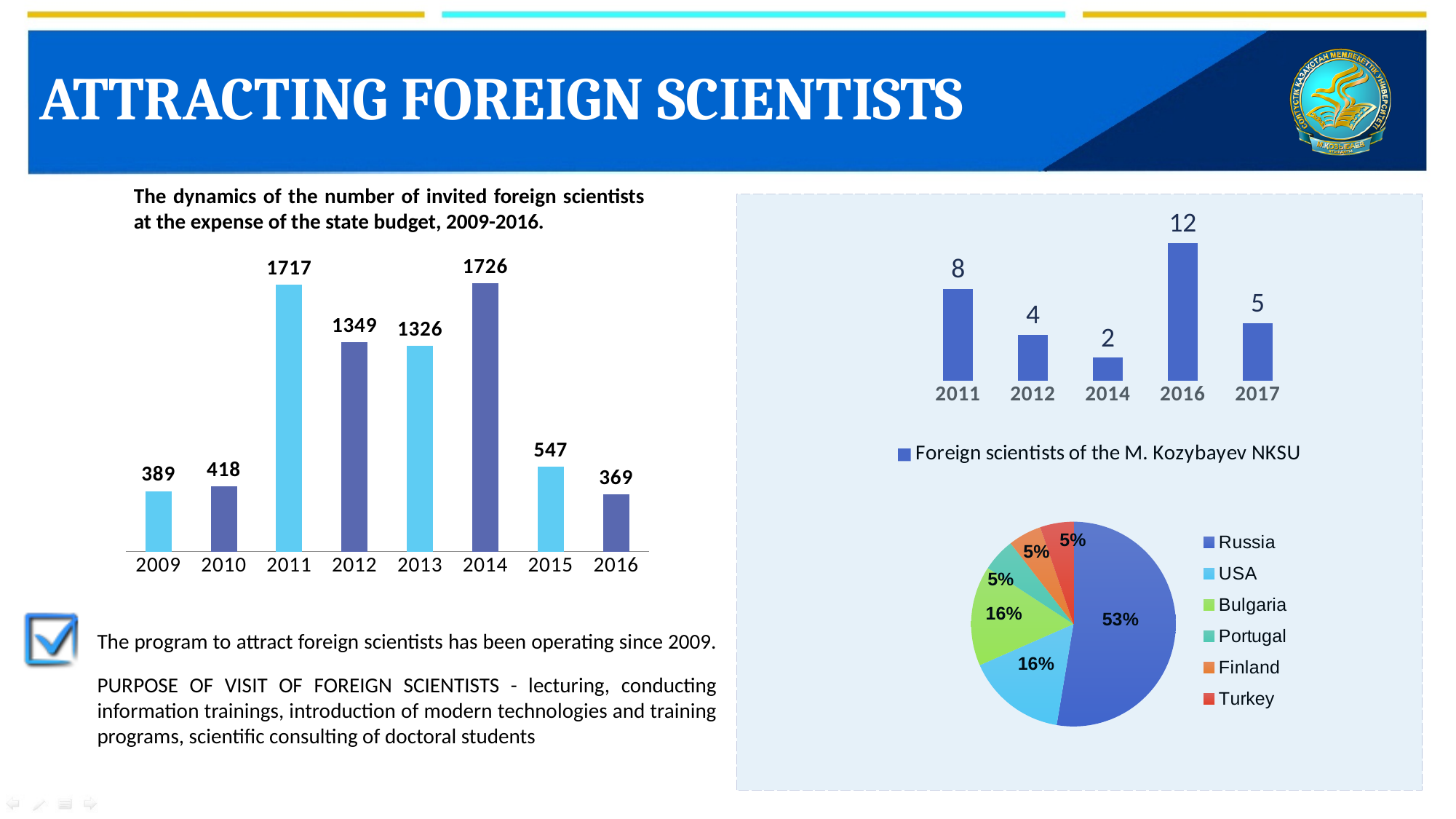
In the left bar chart on the dynamics of invited foreign scientists, which year has the highest value? 2014 In the pie chart at the bottom right, what share does Russia have? 53% In the left bar chart on the dynamics of invited foreign scientists, which is larger, the value for 2012 or the value for 2013? 2012 What kind of chart is the top-right chart 'Foreign scientists of the M. Kozybayev NKSU'? bar chart In the left bar chart on the dynamics of invited foreign scientists, how many years are shown on the x axis? 8 In the left bar chart on the dynamics of invited foreign scientists, what is the difference between the values for 2014 and 2015? 1179 In the top-right chart 'Foreign scientists of the M. Kozybayev NKSU', which year has the lowest value? 2014 In the left bar chart on the dynamics of invited foreign scientists, which year has the lowest value? 2016 In the left bar chart on the dynamics of invited foreign scientists, what is the value for 2011? 1717 How many entries does the legend of the pie chart at the bottom right list? 6 In the top-right chart 'Foreign scientists of the M. Kozybayev NKSU', what is the value for 2016? 12 In the top-right chart 'Foreign scientists of the M. Kozybayev NKSU', what is the difference between the values for 2011 and 2012? 4